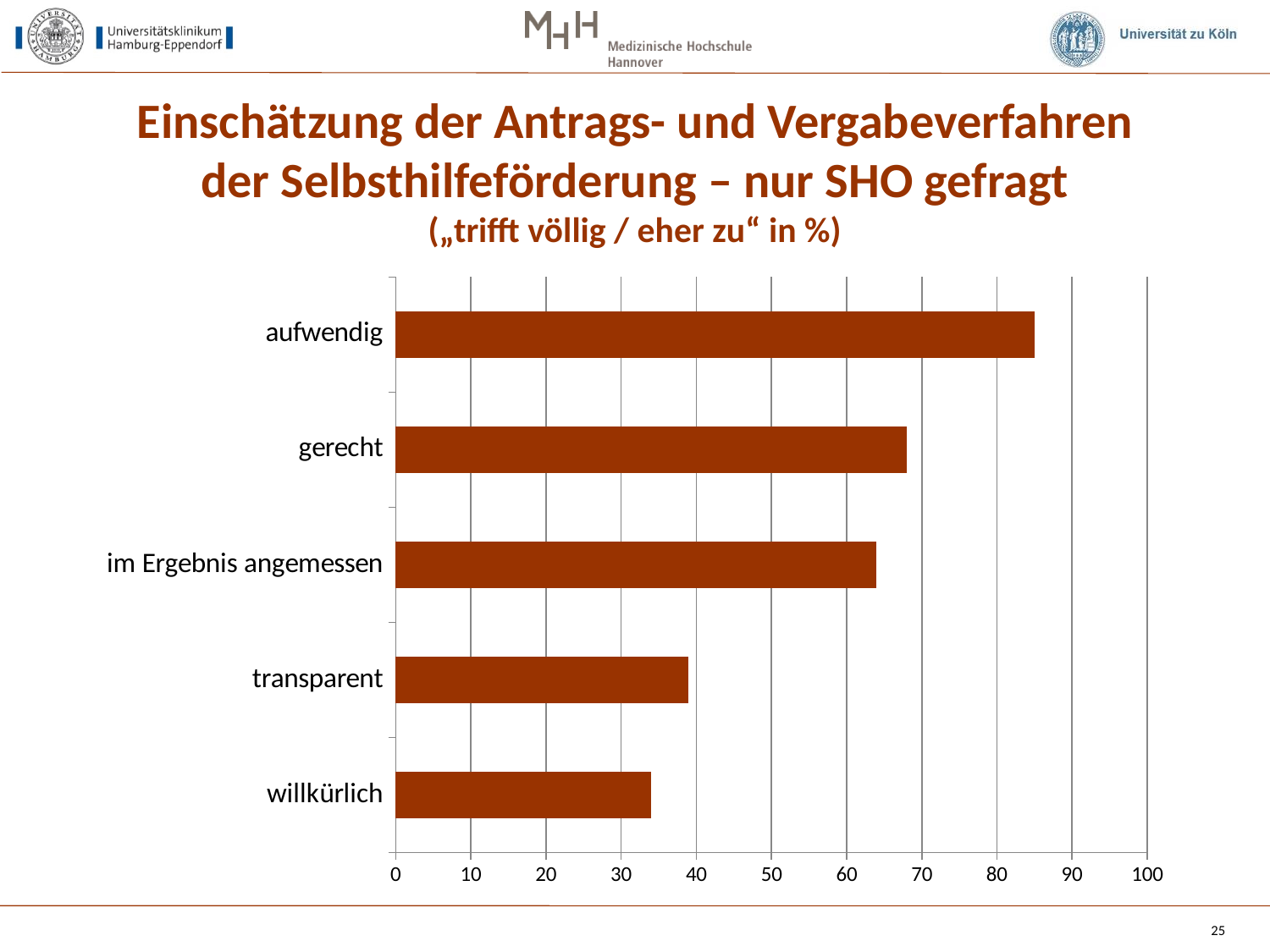
How many categories are shown in the chart? 5 Is the value for aufwendig greater or less than 80? greater Which is larger, the value for gerecht or the value for willkürlich? gerecht Which category has the highest value? aufwendig Is the value for gerecht greater or less than 60? greater Which category has the lowest value? willkürlich Is the value for transparent greater or less than 50? less What is the maximum value shown on the horizontal axis of the chart? 100 What kind of chart is shown on the slide? bar chart Which is larger, the value for aufwendig or the value for transparent? aufwendig